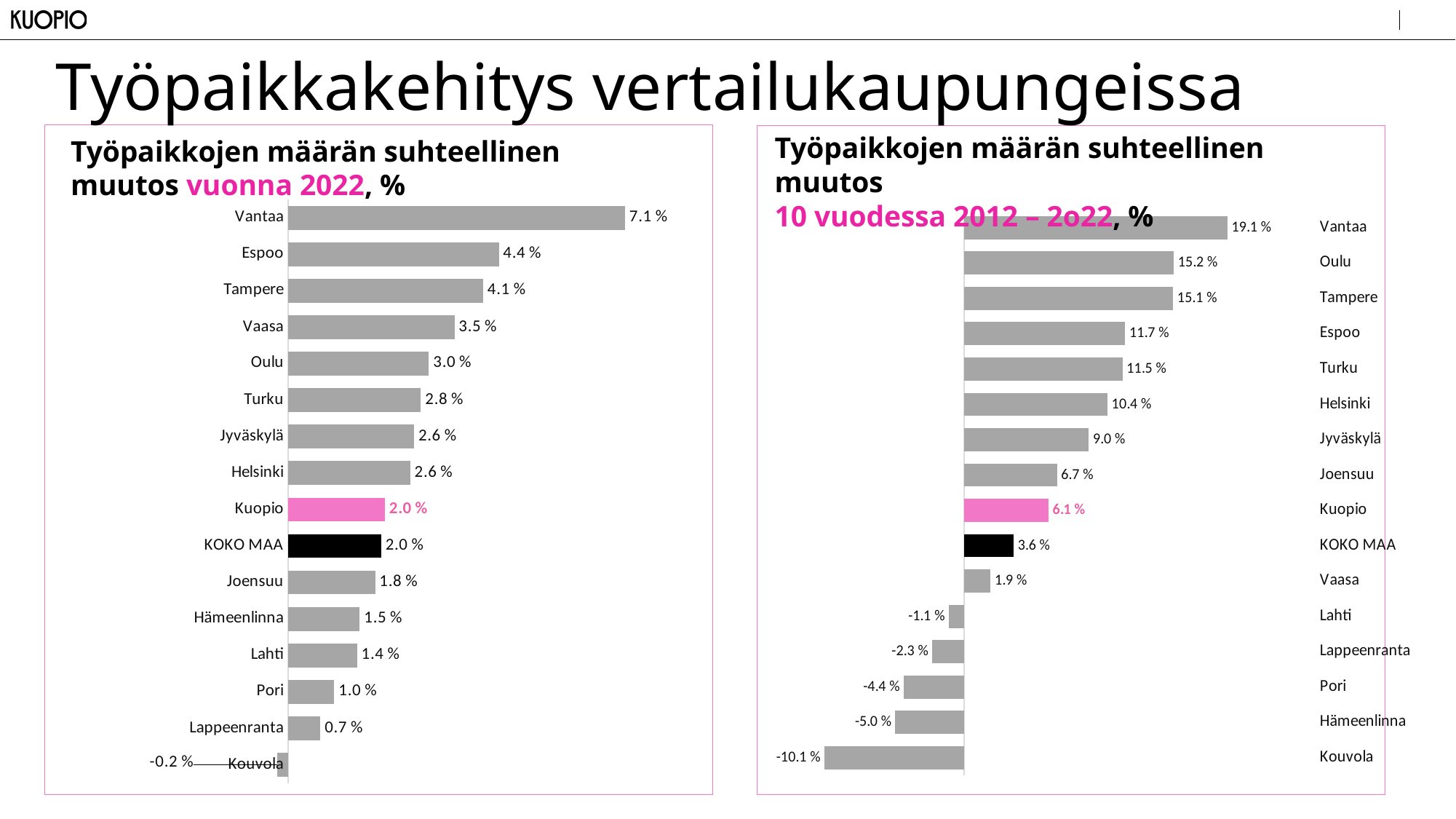
In the right chart (10 vuodessa 2012 – 2022), what is the value for Kuopio? 6.1 % In the right chart (10 vuodessa 2012 – 2022), which city has the highest value? Vantaa In the right chart (10 vuodessa 2012 – 2022), what is the value for Kouvola? -10.1 % In the left chart (vuonna 2022), which city has the highest value? Vantaa In the left chart (vuonna 2022), what is the value for Kuopio? 2.0 % In the right chart (10 vuodessa 2012 – 2022), which is larger, Espoo or Turku? Espoo In the left chart (vuonna 2022), what is the difference between Vantaa and Espoo? 2.7 % In the right chart (10 vuodessa 2012 – 2022), what is the difference between Kuopio and KOKO MAA? 2.5 % What type of chart is the left chart (vuonna 2022)? Bar chart In the left chart (vuonna 2022), how many categories are shown? 16 In the left chart (vuonna 2022), which category has the lowest value? Kouvola In the left chart (vuonna 2022), what is the value for Vaasa? 3.5 %